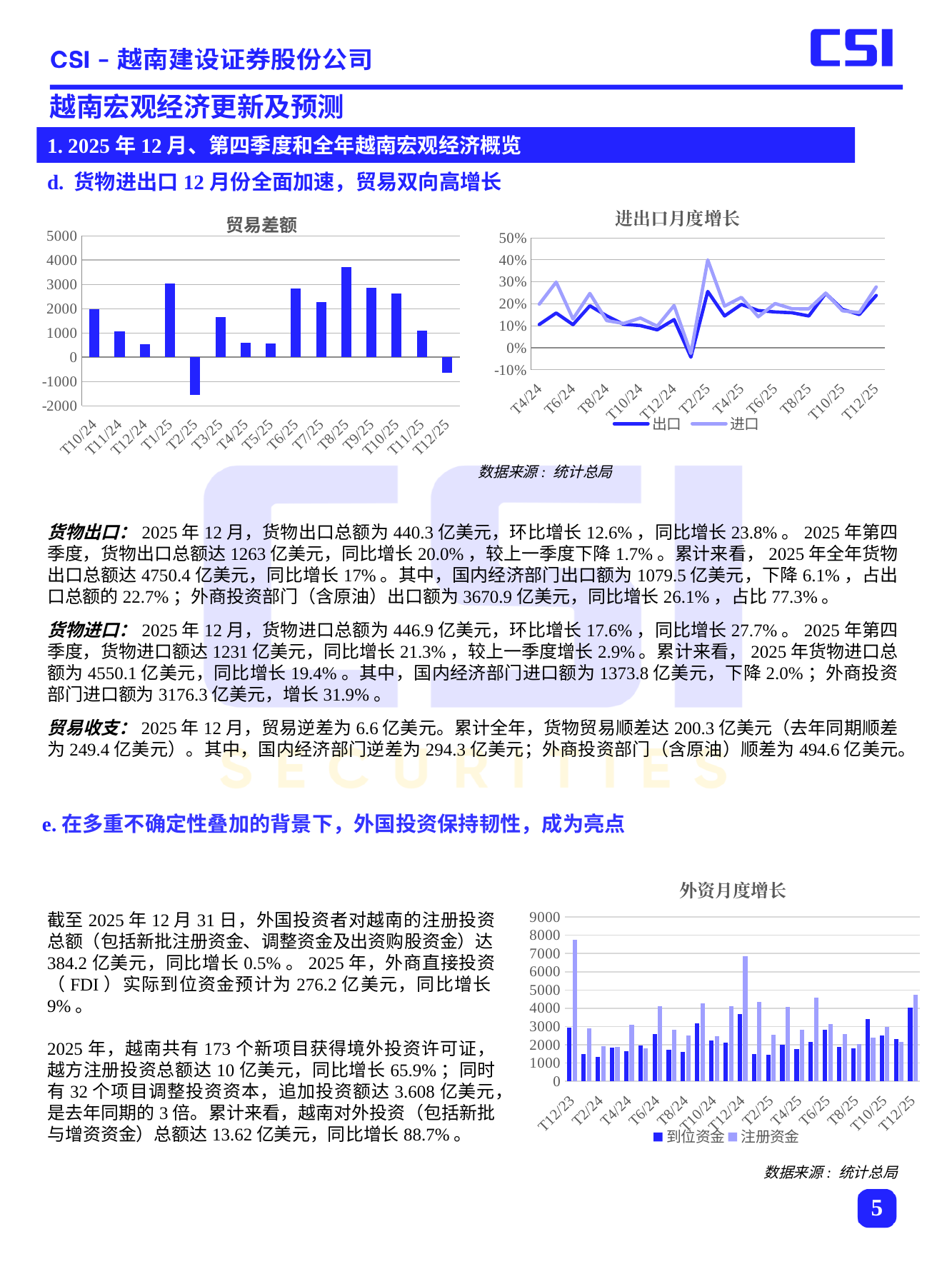
In the 外资月度增长 chart, is the 注册资金 value for T12/23 greater or less than 7000? greater How many months are shown on the x axis of the 贸易差额 chart? 15 In the 贸易差额 chart, which month has the highest trade balance? T8/25 In the 贸易差额 chart, which month has the lowest trade balance? T2/25 How many series does the legend of the 进出口月度增长 chart list? 2 In the 贸易差额 chart, is the value for T12/25 greater or less than 0? less In the 外资月度增长 chart, which series is shown in the darker blue colour? 到位资金 In the 贸易差额 chart, which is larger, the value for T1/25 or the value for T4/25? T1/25 In the 贸易差额 chart, is the value for T10/24 greater or less than 1000? greater What type of chart is the 贸易差额 chart? bar chart In the 进出口月度增长 chart, in which month does the 进口 series reach its highest value? T2/25